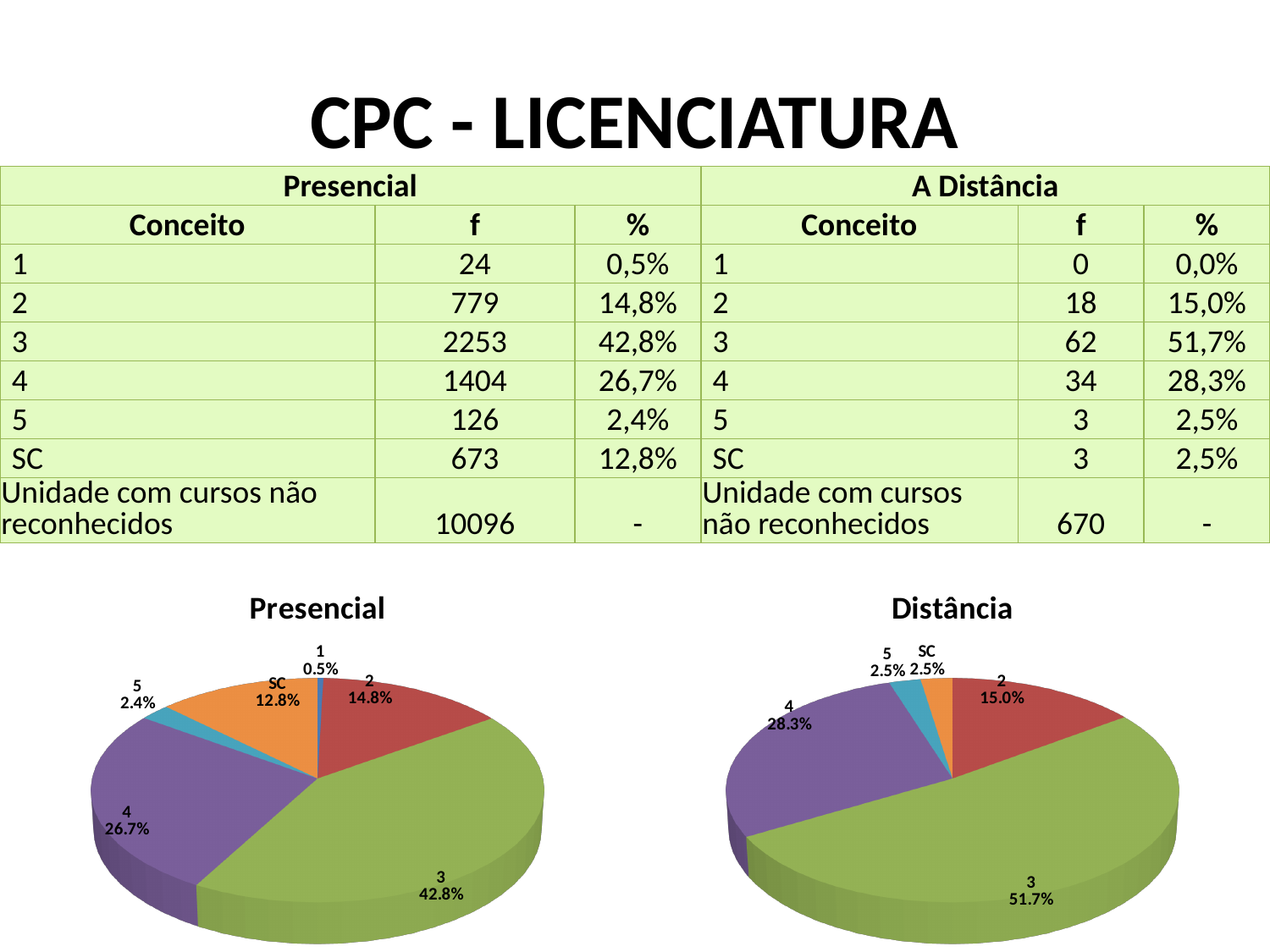
How many slices are labelled in the Distância pie chart? 5 What type of chart is used for Presencial? Pie chart In the Presencial pie chart, what percentage is shown for SC? 12.8% In the Distância pie chart, what percentage is shown for category 5? 2.5% How many slices are labelled in the Presencial pie chart? 6 In the Distância pie chart, what percentage is shown for category 4? 28.3% What is the title of the pie chart on the right side of the slide? Distância In the Presencial pie chart, which category has the smallest slice? 1 In the Presencial pie chart, what is the difference in percentage points between category 3 and category 4? 16.1 In the Presencial pie chart, what percentage is shown for category 3? 42.8% In the Distância pie chart, which is larger, the slice for category 2 or the slice for category 4? 4 In the Distância pie chart, which category has the largest slice? 3